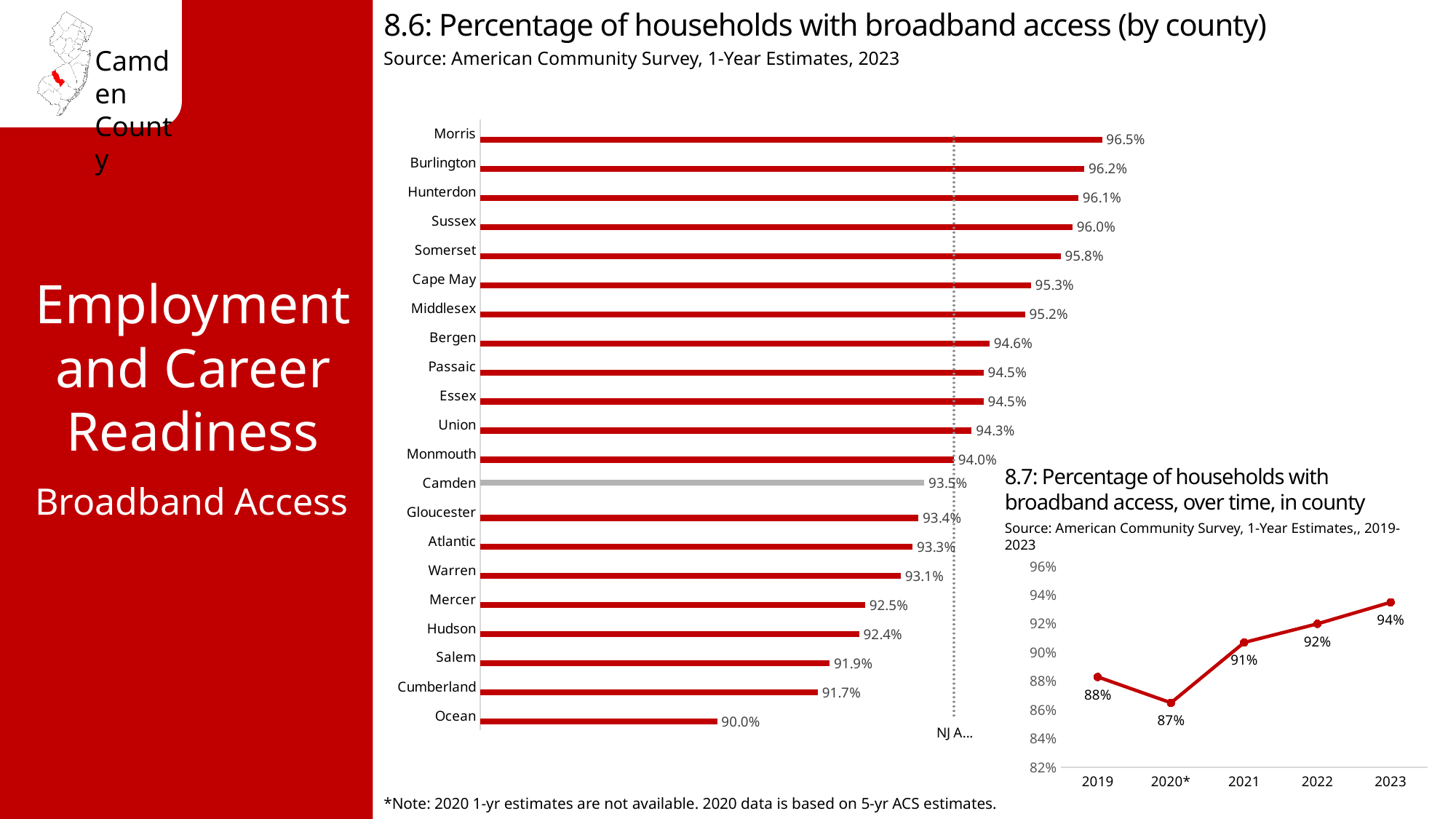
In chart 8.6, how many counties are shown? 21 In chart 8.7, what is the difference in percentage points between 2023 and 2019? 6 In chart 8.6, which county has the lowest percentage of households with broadband access? Ocean In chart 8.6, what is the value for Cumberland? 91.7% In chart 8.6, what percentage of households in Camden County have broadband access? 93.5% In chart 8.6, what is the difference in percentage points between Morris and Ocean? 6.5 In chart 8.6, which county has the highest percentage of households with broadband access? Morris In chart 8.6, which county has a higher value, Mercer or Hudson? Mercer What kind of chart is chart 8.6? Bar chart In chart 8.7, how many years are plotted? 5 In chart 8.7, which year has the highest value? 2023 In chart 8.7, what was the percentage of households with broadband access in 2020? 87%